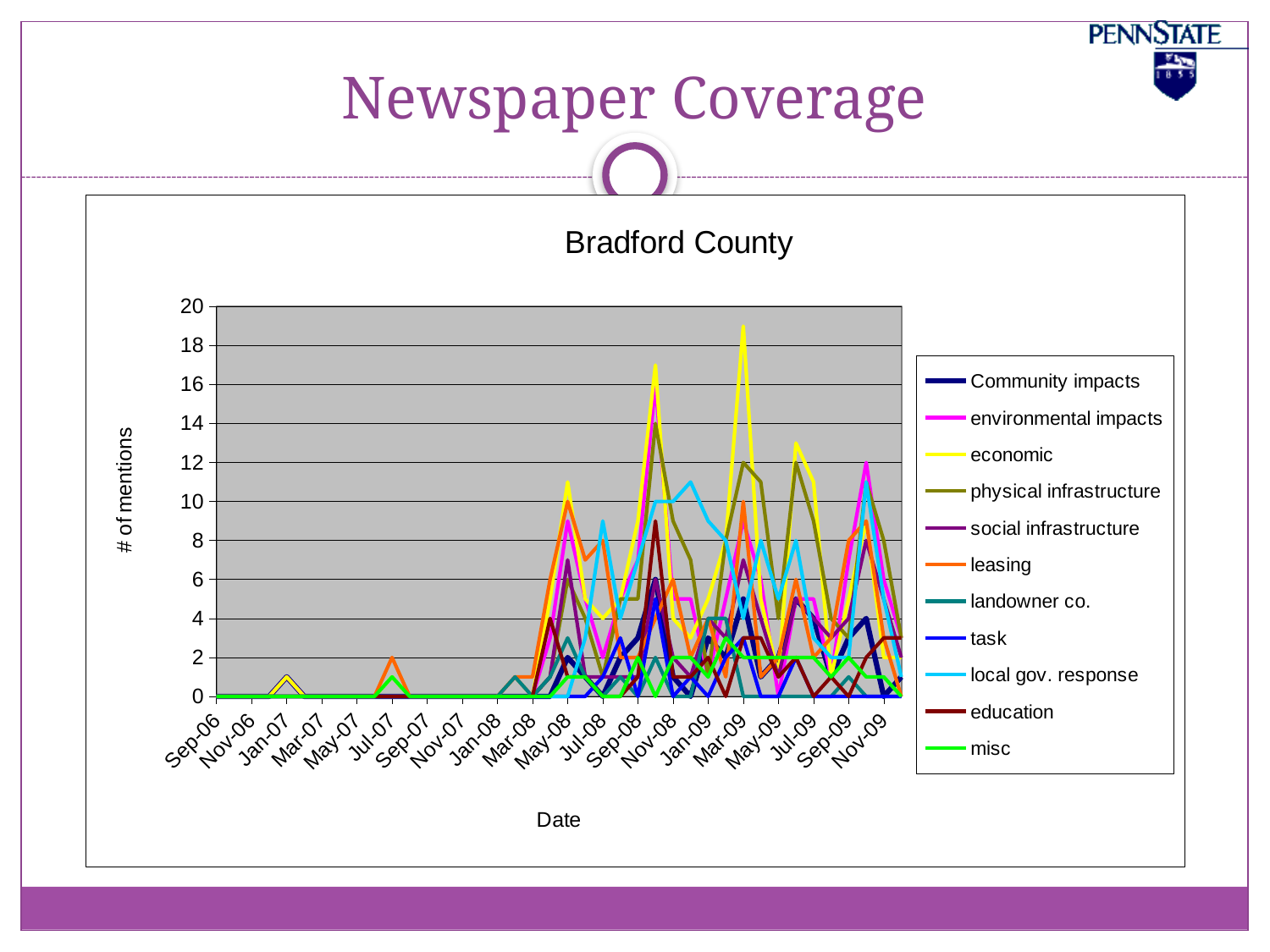
Is the peak value of the physical infrastructure series greater or less than 12? greater Is the peak value of the economic series greater or less than 16? greater How many series does the legend list? 11 Is the highest value of the education series greater or less than 10? less Which series reaches a higher peak, economic or local gov. response? economic What kind of chart is shown on the slide? line chart What is the label on the y axis? # of mentions What is the title of the chart? Bradford County Do the numbers of mentions generally rise or fall from Sep-06 to Nov-09? rise Which series reaches the highest number of mentions at any point on the chart? economic